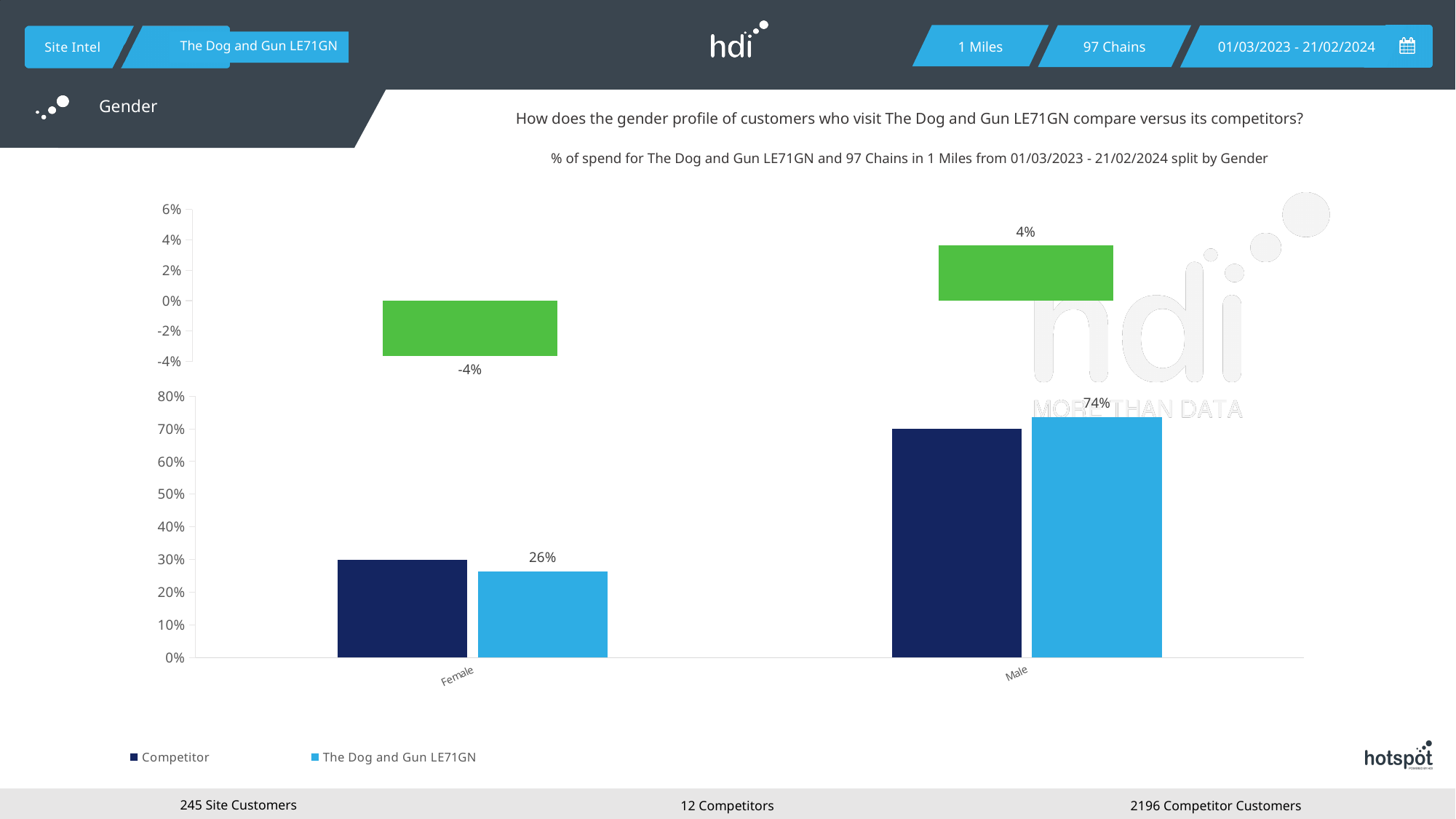
In the top chart, what is the value shown for Male? 4% In the bottom chart, for Male, which is larger: the Competitor value or The Dog and Gun LE71GN value? The Dog and Gun LE71GN In the bottom chart, what is the difference between The Dog and Gun LE71GN's Male and Female values? 48% In the bottom chart, what is the value for The Dog and Gun LE71GN for Female? 26% In the bottom chart, what is the value for The Dog and Gun LE71GN for Male? 74% In the bottom chart, for Female, which is larger: the Competitor value or The Dog and Gun LE71GN value? Competitor In the bottom chart, is the Competitor value for Female greater or less than 40%? less What kind of chart is the bottom chart? Bar chart How many series does the legend of the bottom chart list? 2 In the bottom chart, which gender category has the highest value for The Dog and Gun LE71GN? Male In the bottom chart, is the Competitor value for Male greater or less than 60%? greater In the top chart, what is the value shown for Female? -4%